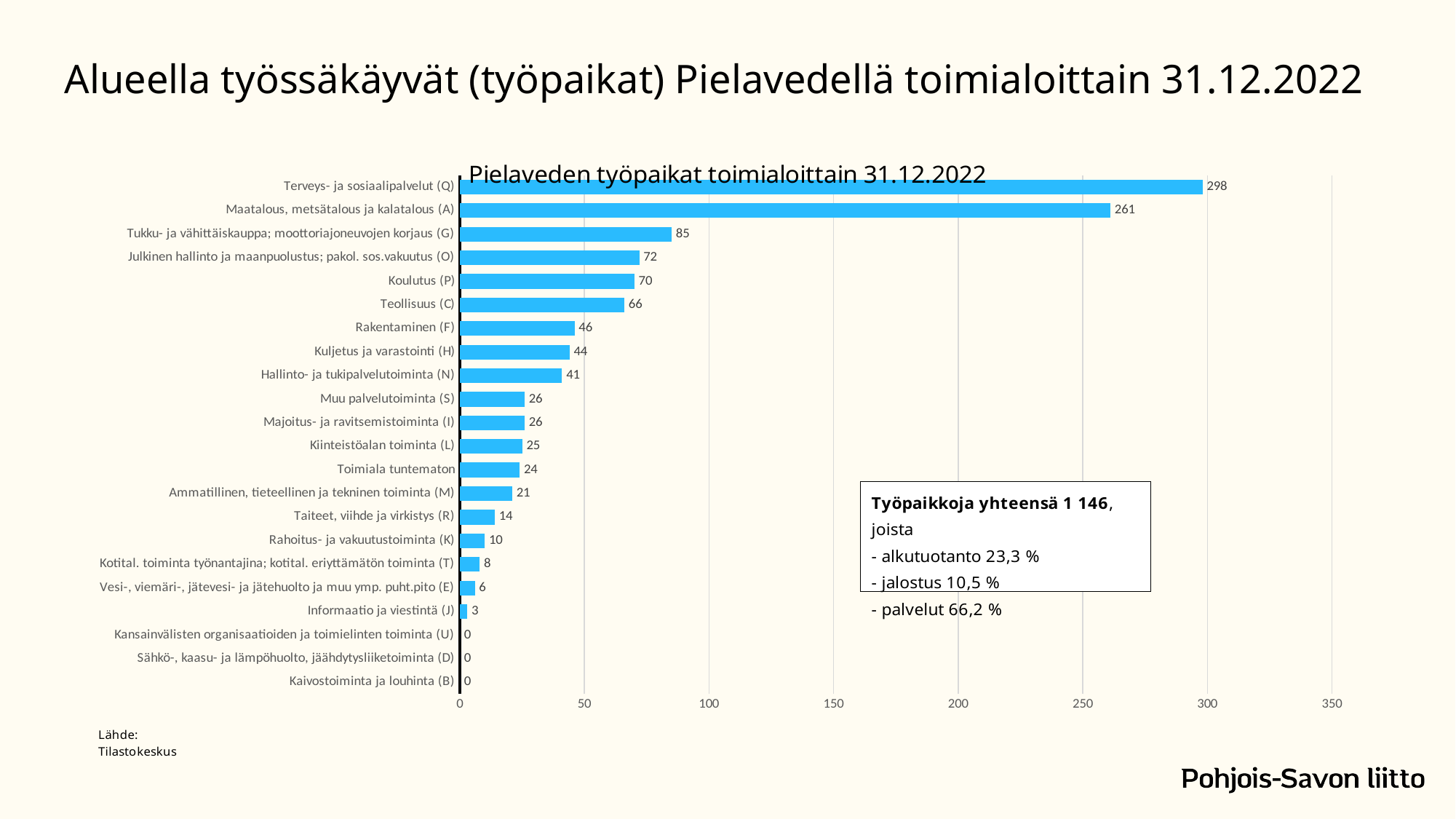
Which is larger, the value for Koulutus (P) or the value for Teollisuus (C)? Koulutus (P) What is the difference between the values for Terveys- ja sosiaalipalvelut (Q) and Maatalous, metsätalous ja kalatalous (A)? 37 What is the title of the chart? Pielaveden työpaikat toimialoittain 31.12.2022 How many categories have a value of 0? 3 Which category has the highest value? Terveys- ja sosiaalipalvelut (Q) What is the value for Maatalous, metsätalous ja kalatalous (A)? 261 How many categories are shown in the chart? 22 Is the value for Tukku- ja vähittäiskauppa; moottoriajoneuvojen korjaus (G) greater or less than 50? greater What is the value for Rakentaminen (F)? 46 What is the value for Terveys- ja sosiaalipalvelut (Q)? 298 What is the value for Taiteet, viihde ja virkistys (R)? 14 What kind of chart is shown on the slide? bar chart